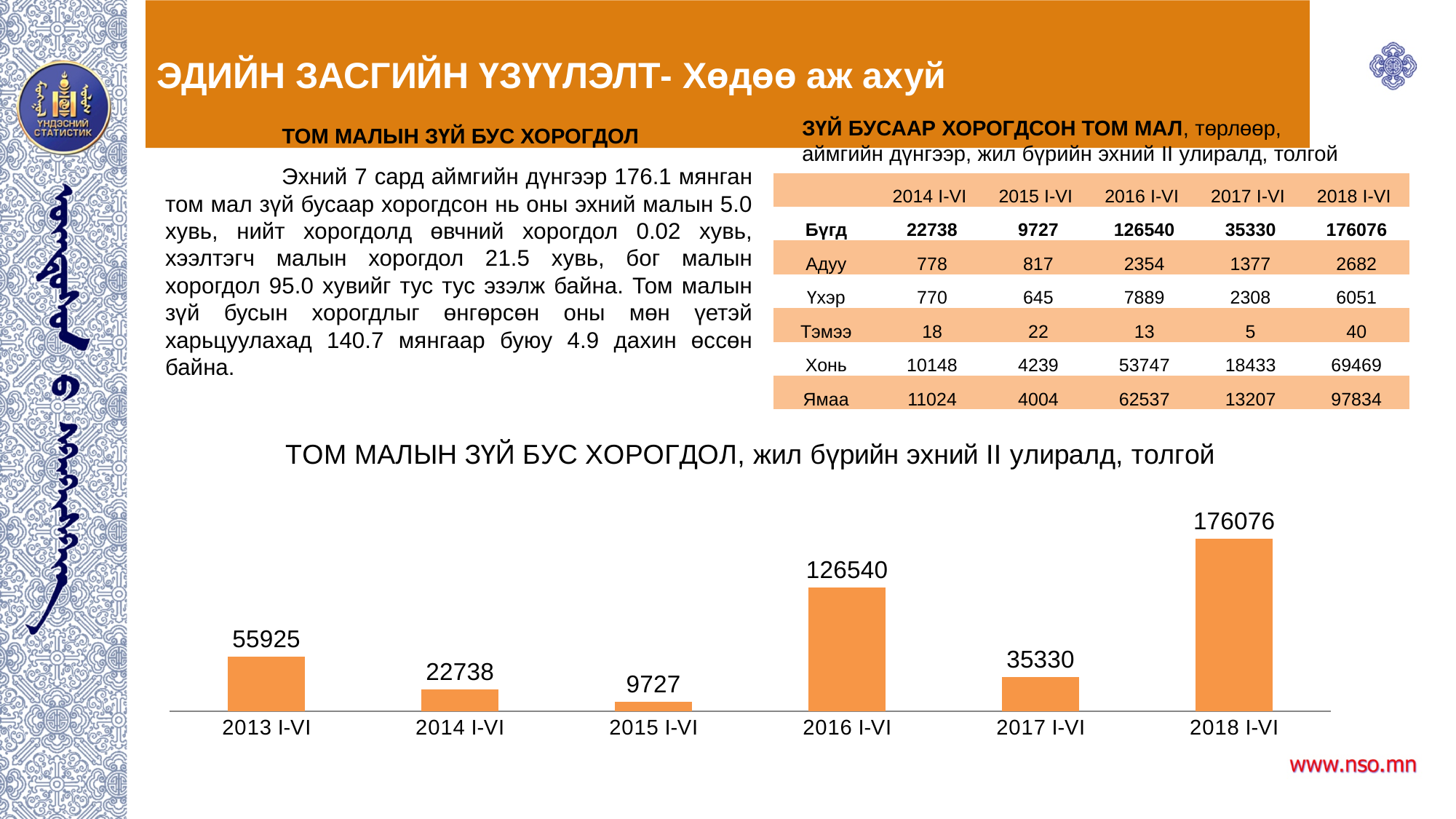
What is the difference between the values for 2013 I-VI and 2014 I-VI? 33187 What is the value for 2018 I-VI in the chart? 176076 What is the difference between the values for 2018 I-VI and 2016 I-VI? 49536 What kind of chart is shown on the slide? bar chart Which period has the lowest value in the chart? 2015 I-VI What is the value for 2015 I-VI in the chart? 9727 Which period has the highest value in the chart? 2018 I-VI Which is larger, the value for 2016 I-VI or the value for 2017 I-VI? 2016 I-VI How many periods are shown on the x axis of the chart? 6 What is the value for 2017 I-VI in the chart? 35330 What is the value for 2013 I-VI in the chart? 55925 What is the title of the chart? ТОМ МАЛЫН ЗҮЙ БУС ХОРОГДОЛ, жил бүрийн эхний II улиралд, толгой